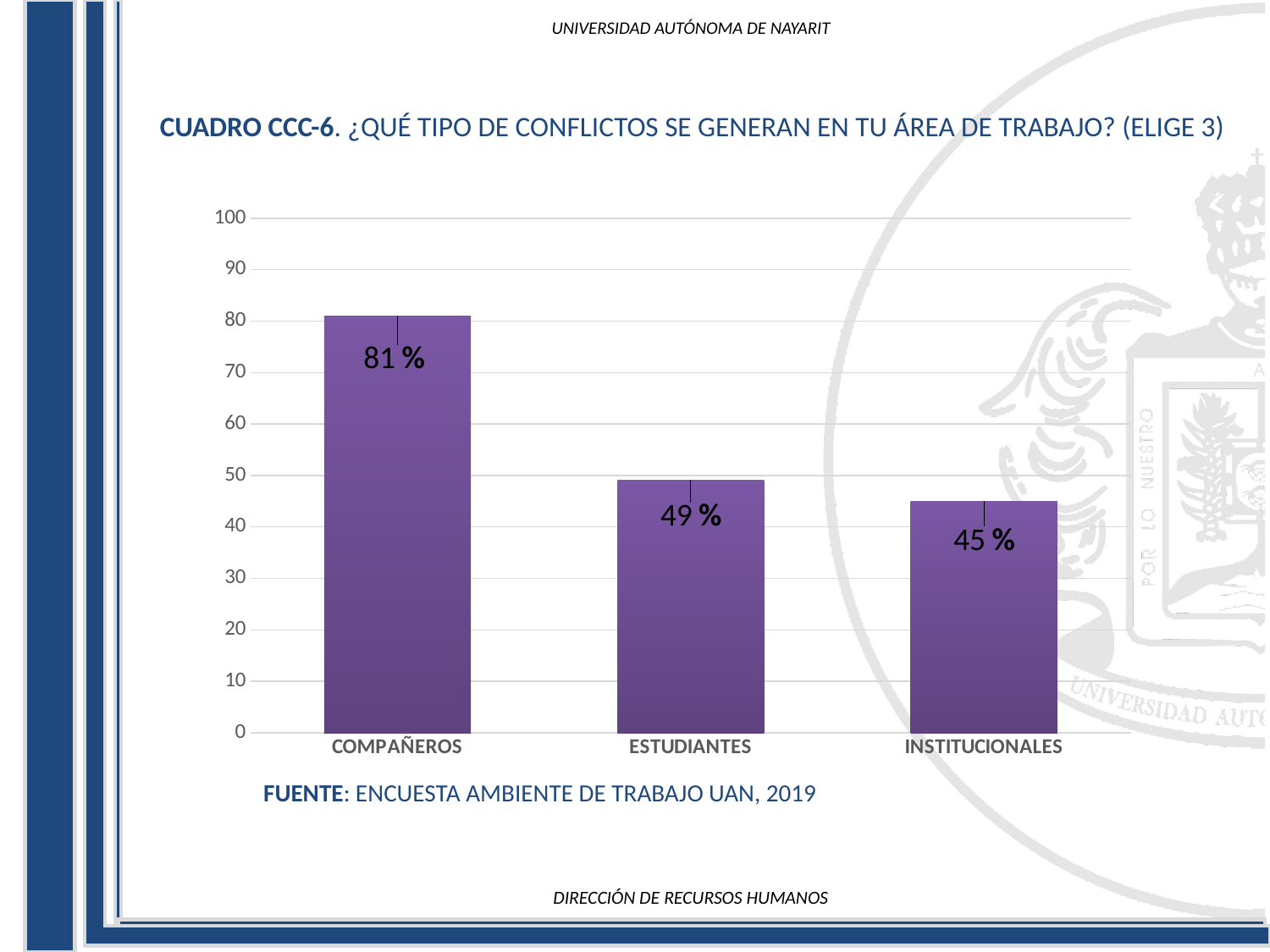
What kind of chart is shown on the slide? bar chart What source is cited below the chart? ENCUESTA AMBIENTE DE TRABAJO UAN, 2019 How many categories are shown on the x axis? 3 What is the value for INSTITUCIONALES? 45 % Which is larger, the value for COMPAÑEROS or the value for INSTITUCIONALES? COMPAÑEROS Is the value for ESTUDIANTES greater or less than 60? less What is the value for ESTUDIANTES? 49 % What is the value for COMPAÑEROS? 81 % Which category has the highest value? COMPAÑEROS What is the difference between the values for COMPAÑEROS and ESTUDIANTES? 32 % Which category has the lowest value? INSTITUCIONALES What is the difference between the values for ESTUDIANTES and INSTITUCIONALES? 4 %